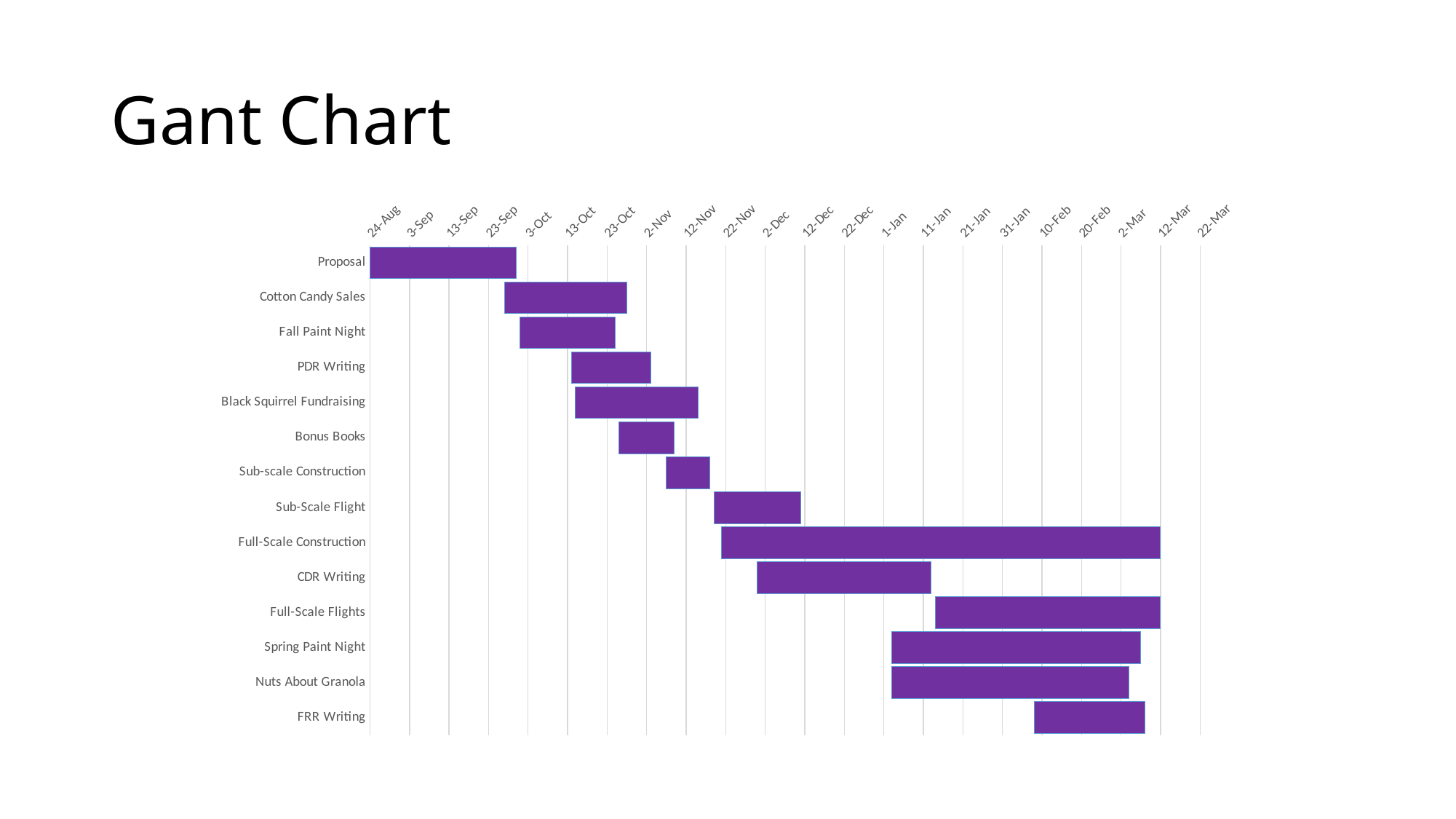
Which bar is longer, Cotton Candy Sales or Fall Paint Night? Cotton Candy Sales What kind of chart is shown on the slide? Bar chart (Gantt chart) Which task starts earliest in the chart? Proposal How many tasks are listed on the vertical axis of the chart? 14 Which task has the shortest bar in the chart? Sub-scale Construction Which task has the longest bar in the chart? Full-Scale Construction Does the Proposal bar end before or after 23-Sep? after Does the FRR Writing bar start before or after 31-Jan? after What is the title of the slide? Gant Chart What colour are the bars in the chart? Purple Does the Sub-Scale Flight bar start before or after 12-Nov? after Which bar is longer, Full-Scale Construction or CDR Writing? Full-Scale Construction